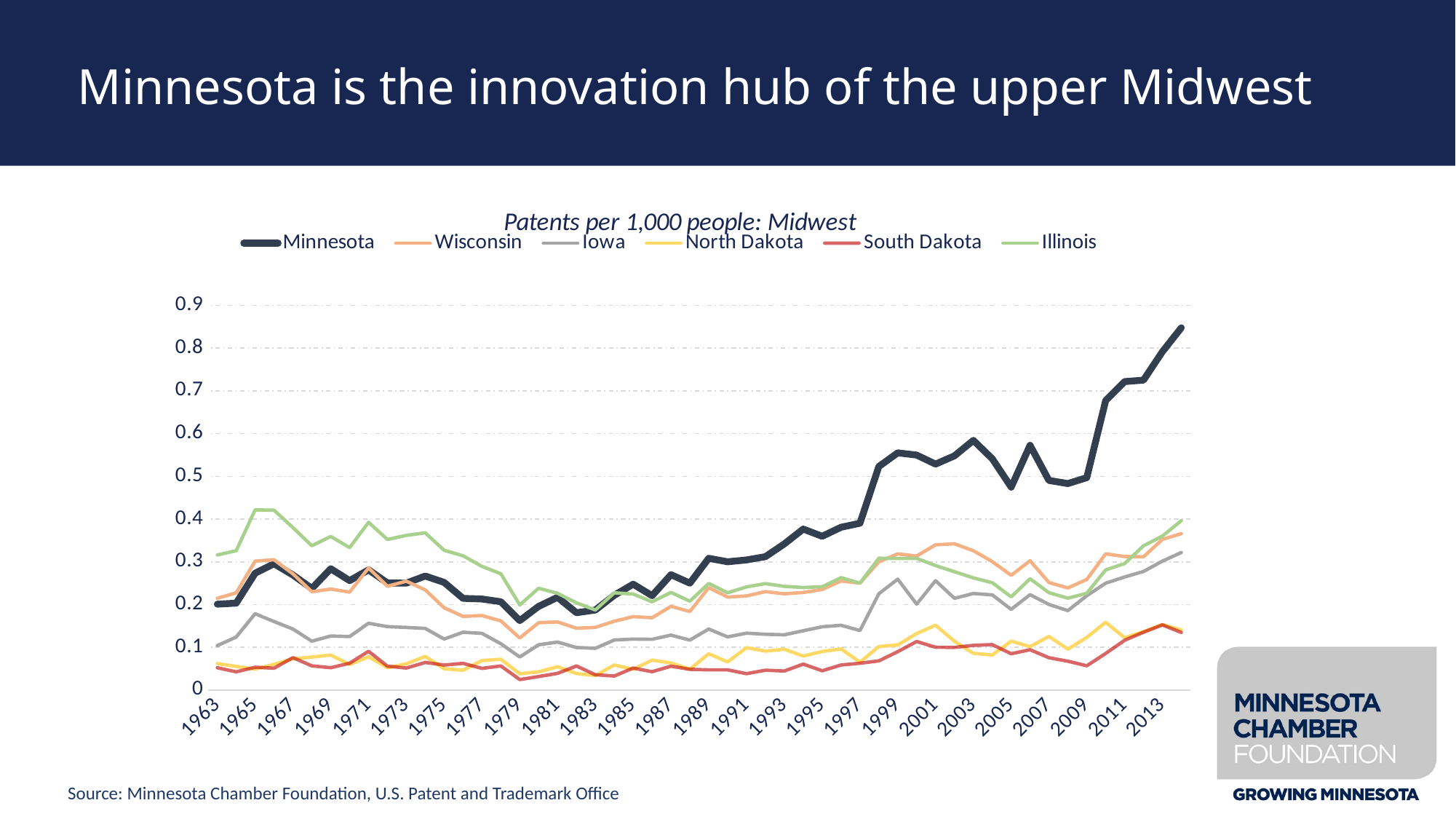
Which is larger in 1965, the value for Minnesota or the value for Illinois? Illinois Is the value for Minnesota in 2014 greater or less than 0.8? greater Which series has the highest value in 1965? Illinois Which series has the highest value at the right end of the chart (2014)? Minnesota What is the title of the chart? Patents per 1,000 people: Midwest Does the Minnesota line overall rise or fall from 1997 to 2014? rise How many series does the legend list? 6 Is the value for Illinois in 1966 greater or less than 0.4? greater Which series is drawn with the thickest line? Minnesota Is the value for South Dakota in 1979 greater or less than 0.1? less What kind of chart is shown on the slide? line chart